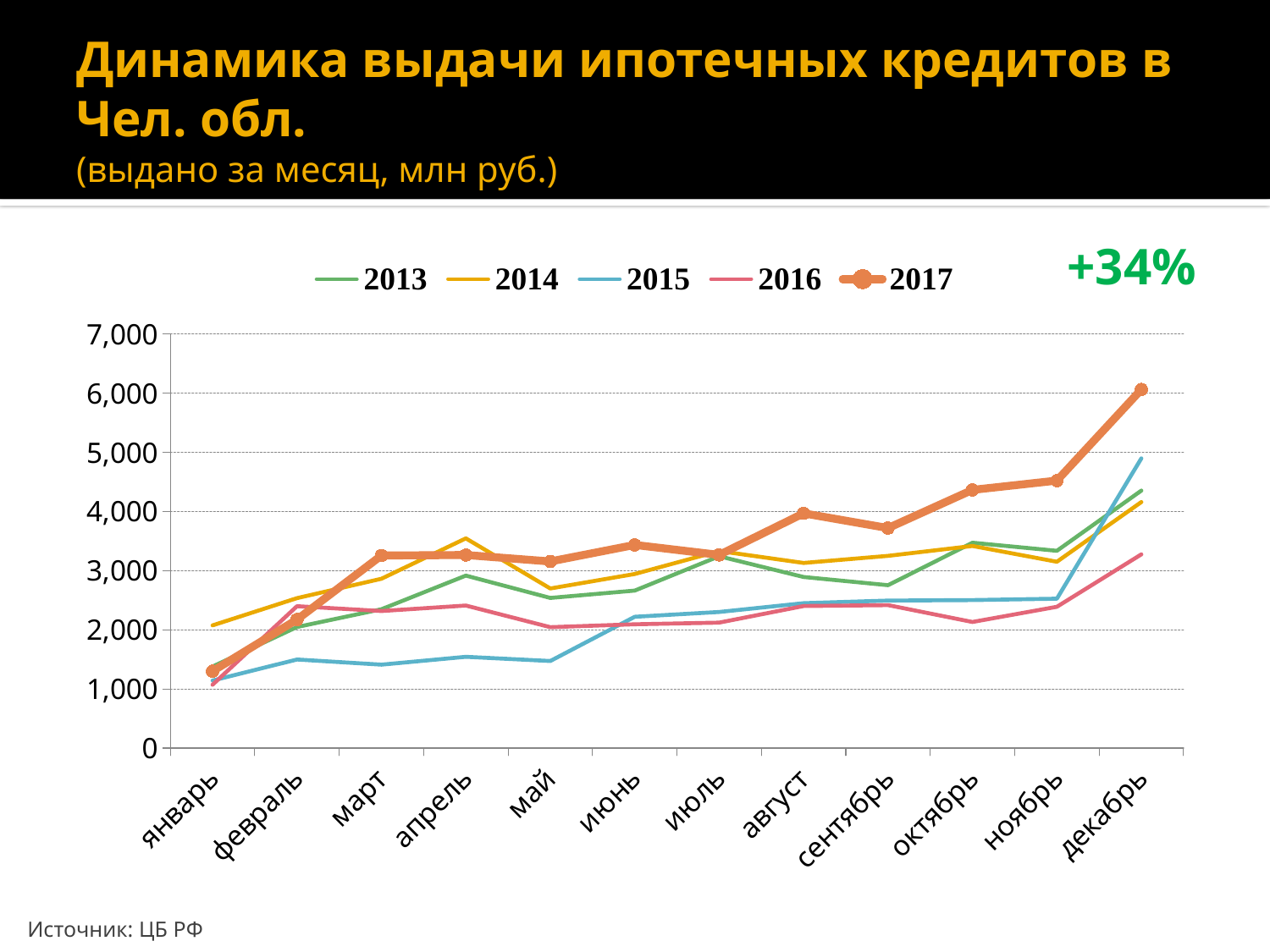
In which month does the 2017 series reach its lowest value? январь Does the 2017 series rise or fall from январь to декабрь? rise Is the value for 2017 in декабрь greater or less than 5,000? greater What kind of chart is shown on the slide? line chart Which series has the highest value in декабрь? 2017 In август, which is larger: the value for 2017 or the value for 2016? 2017 How many months are plotted along the x axis? 12 Is the value for 2015 in январь greater or less than 2,000? less What percentage figure is shown in green above the chart? +34% Which series has the lowest value in декабрь? 2016 Is the value for 2014 in апрель greater or less than 3,000? greater How many series does the legend list? 5